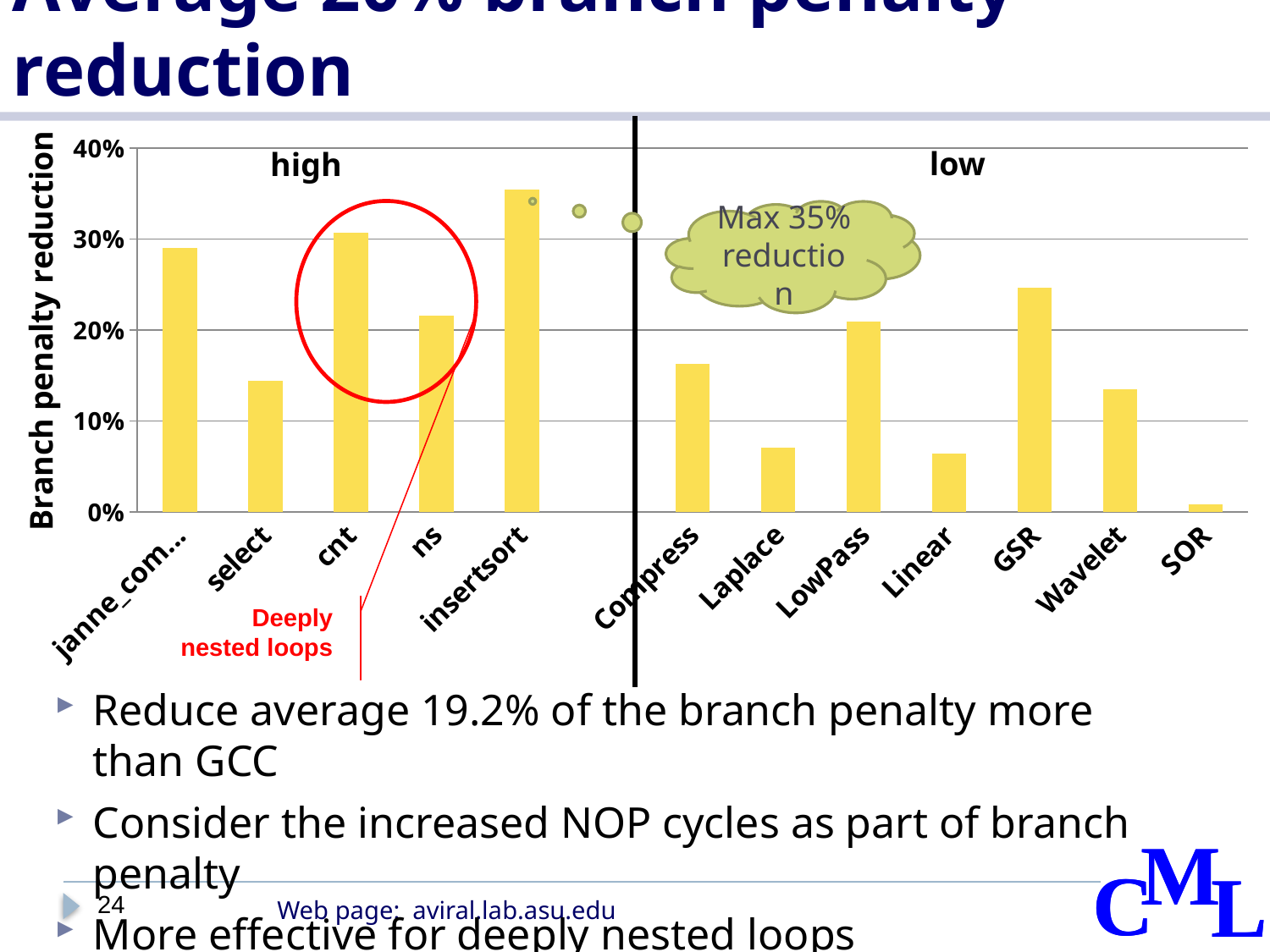
Is the value for GSR greater or less than 20%? greater Which has a larger branch penalty reduction, GSR or Wavelet? GSR Which category has the highest branch penalty reduction? insertsort Which has a larger branch penalty reduction, cnt or select? cnt What is the label of the vertical axis? Branch penalty reduction Is the value for insertsort greater or less than 30%? greater Is the value for SOR greater or less than 10%? less What kind of chart is shown on the slide? bar chart How many categories (benchmarks) are plotted on the x axis? 12 Which category has the lowest branch penalty reduction? SOR